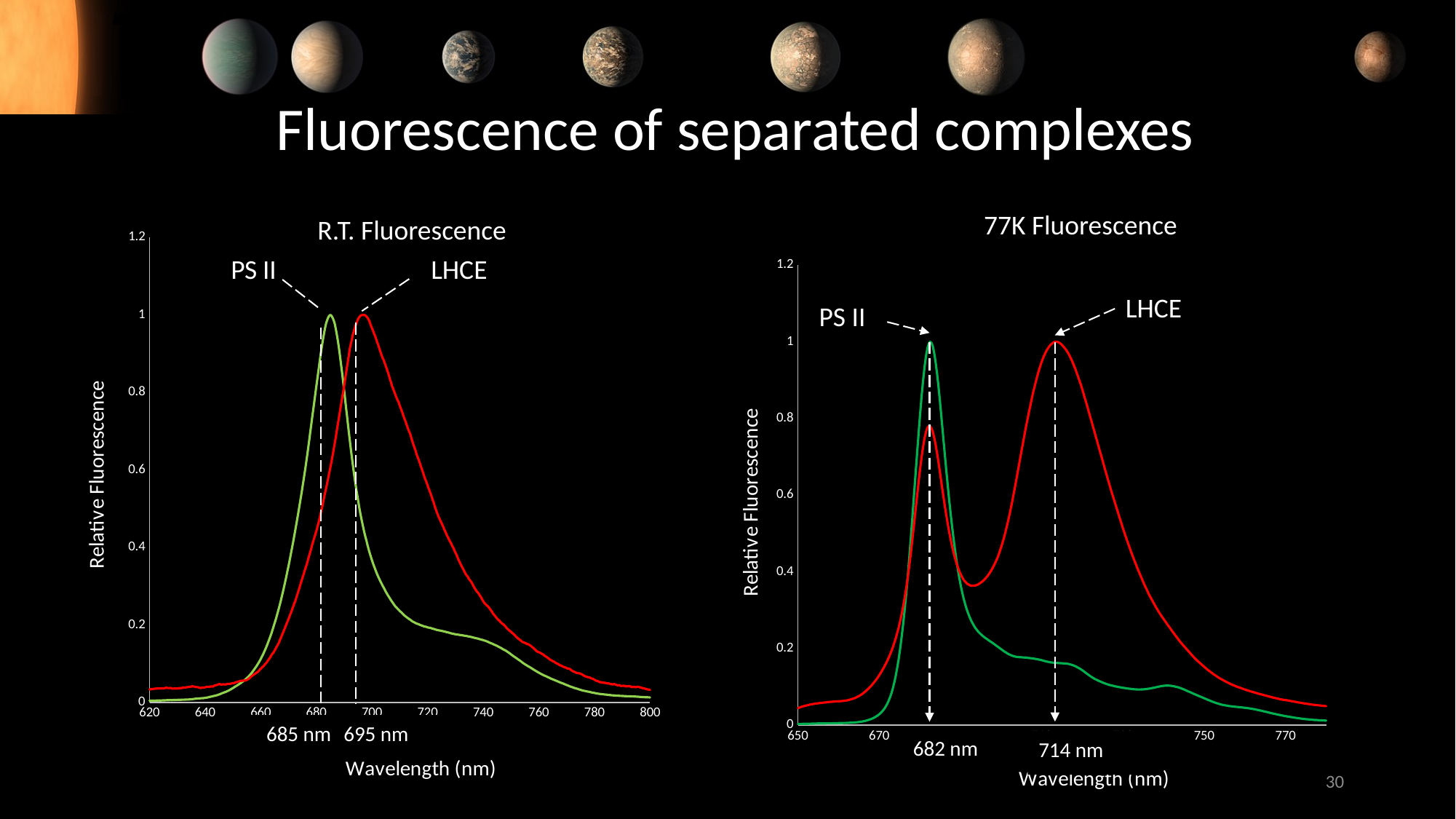
In the R.T. Fluorescence chart, how many nanometres separate the LHCE peak from the PS II peak? 10 nm In the 77K Fluorescence chart, is the red LHCE curve's value at 682 nm greater or less than 0.6? greater In the R.T. Fluorescence chart, at what wavelength does the PS II curve peak? 685 nm In the 77K Fluorescence chart, at what wavelength does the LHCE peak occur? 714 nm In the 77K Fluorescence chart, which curve peaks at the longer wavelength, PS II or LHCE? LHCE What kind of chart is the R.T. Fluorescence chart? line chart How many curves are plotted in the R.T. Fluorescence chart? 2 In the 77K Fluorescence chart, at what wavelength does the PS II peak occur? 682 nm In the 77K Fluorescence chart, how many nanometres separate the LHCE peak from the PS II peak? 32 nm What is the label of the y axis on the 77K Fluorescence chart? Relative Fluorescence In the R.T. Fluorescence chart, at what wavelength does the LHCE curve peak? 695 nm In the 77K Fluorescence chart, is the green PS II curve's value at 714 nm greater or less than 0.4? less